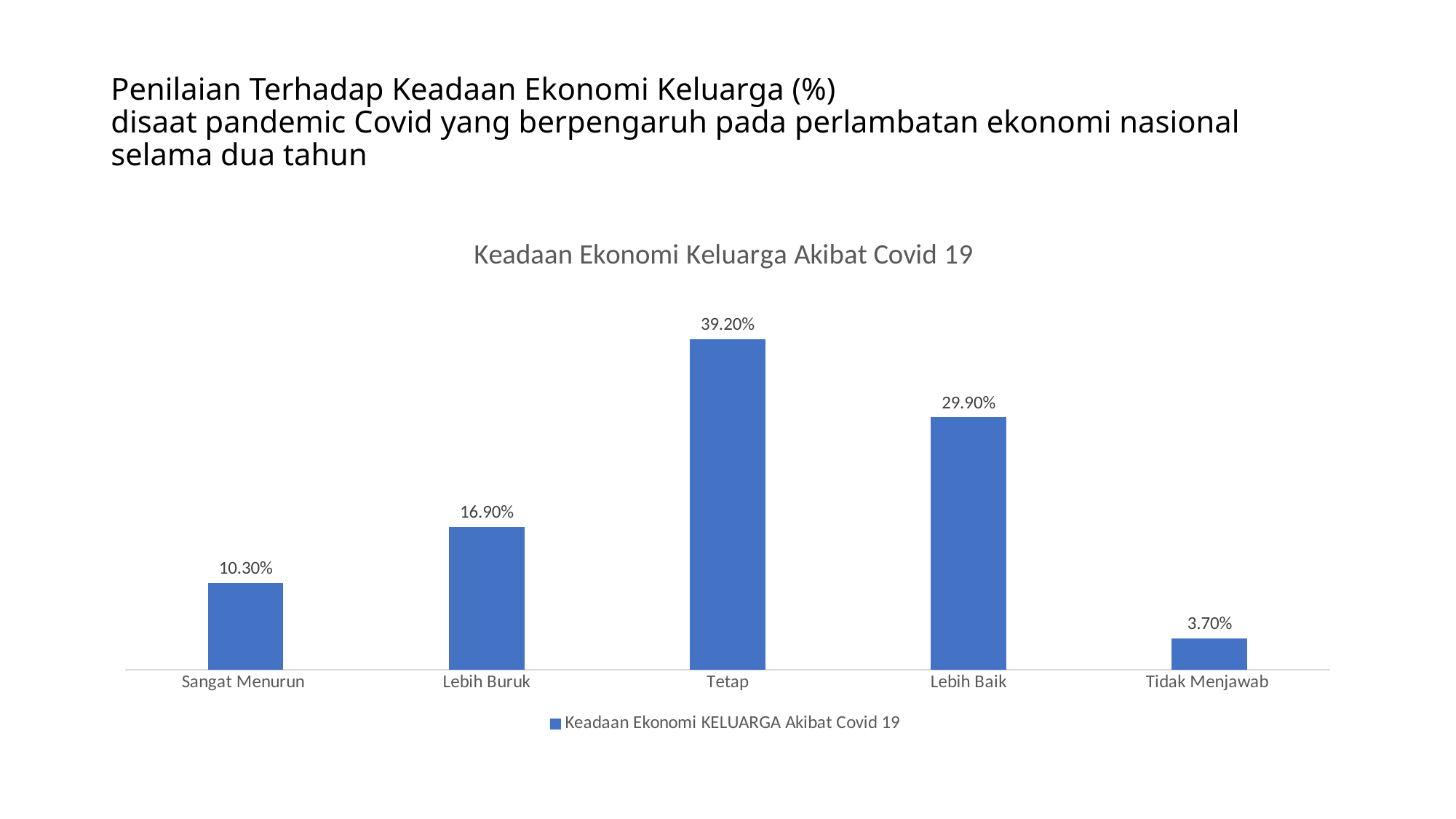
What kind of chart is shown on the slide? Bar chart What is the difference between the values for Tetap and Lebih Baik? 9.30% What is the difference between the values for Lebih Buruk and Sangat Menurun? 6.60% What is the value for Lebih Baik? 29.90% Which category has the highest value? Tetap What is the value for Tidak Menjawab? 3.70% What is the value for Sangat Menurun? 10.30% What is the title of the chart? Keadaan Ekonomi Keluarga Akibat Covid 19 Which category has the lowest value? Tidak Menjawab Which is larger, the value for Lebih Buruk or the value for Lebih Baik? Lebih Baik How many categories are shown on the x axis? 5 What is the value for Tetap? 39.20%